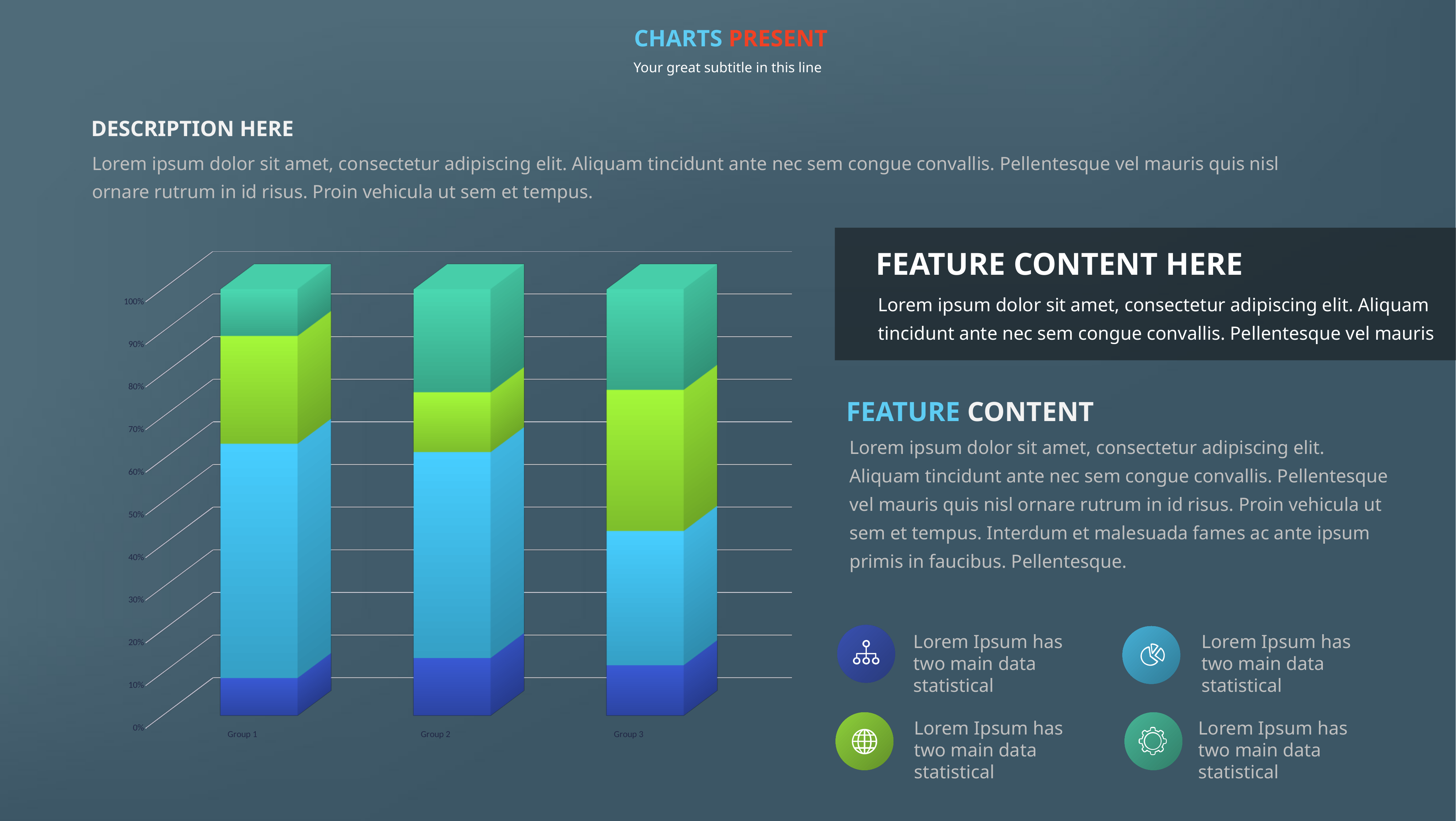
How many groups are shown on the x axis of the chart? 3 What is the highest tick value shown on the y axis of the chart? 100% Is the light blue segment for Group 1 greater or less than 30%? greater Which group has the largest green segment? Group 3 What kind of chart is shown on the slide? Stacked bar chart Is the green segment for Group 3 greater or less than 20%? greater Which group has the smallest light blue segment? Group 3 What are the category labels on the x axis of the chart? Group 1, Group 2, Group 3 How many coloured segments make up each bar in the chart? 4 Is the dark blue bottom segment for Group 1 greater or less than 30%? less What total does the Group 1 bar reach on the y axis? 100%